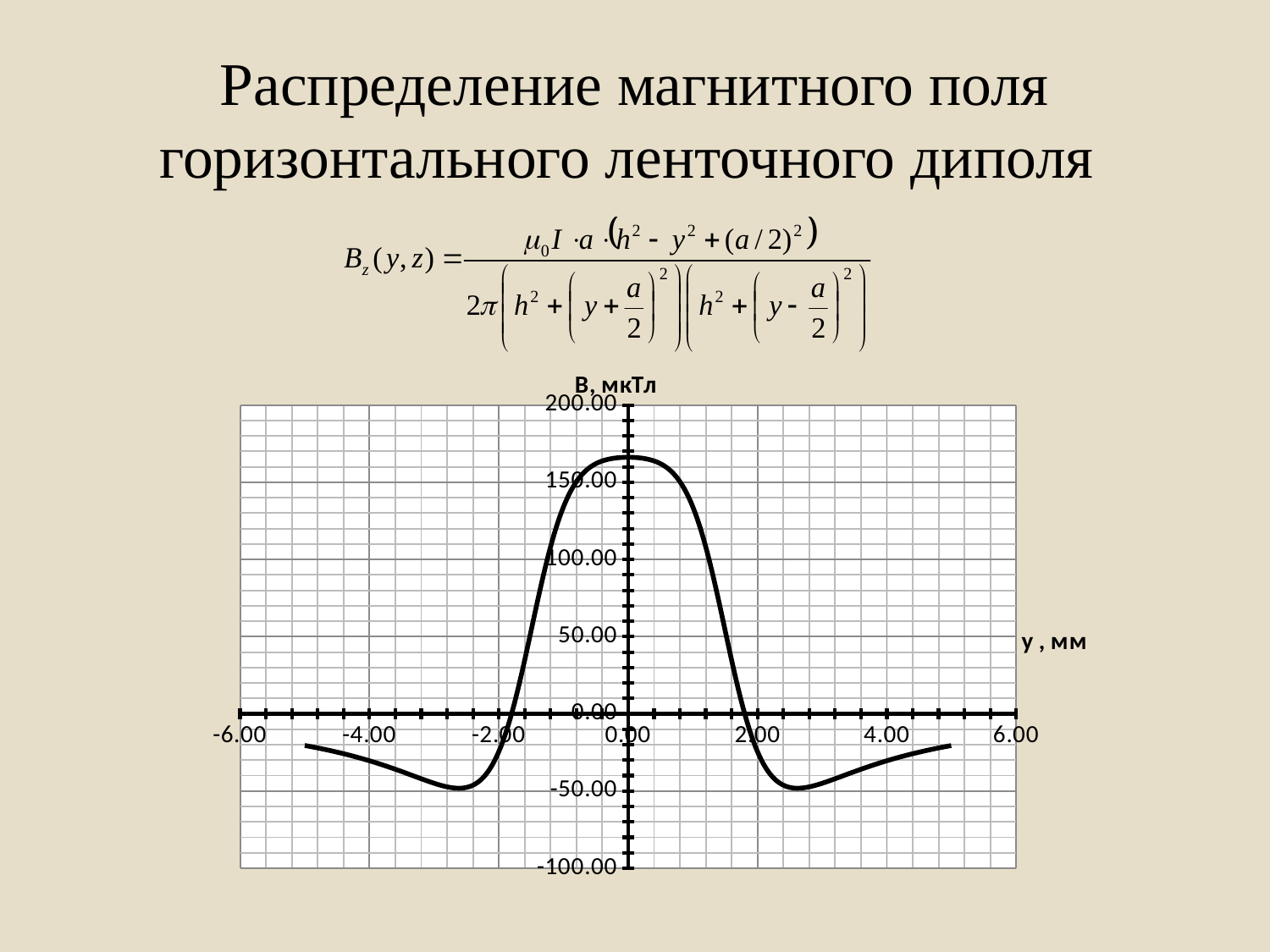
What is the label of the horizontal axis of the chart? y , мм Is the value of B at y = 1.00 greater or less than 100.00? greater What kind of chart is shown on the slide? line chart Is the value of B at y = -2.50 greater or less than -100.00? greater Which is larger, the value of B at y = 0.00 or at y = 4.00? y = 0.00 Is the value of B at y = 0.00 greater or less than 150.00? greater Does the curve rise or fall as y increases from 0.00 to 2.00? fall Does the curve rise or fall as y increases from -2.50 to 0.00? rise At which value of y does the curve reach its highest value? 0.00 What is the label of the vertical axis of the chart? B, мкТл